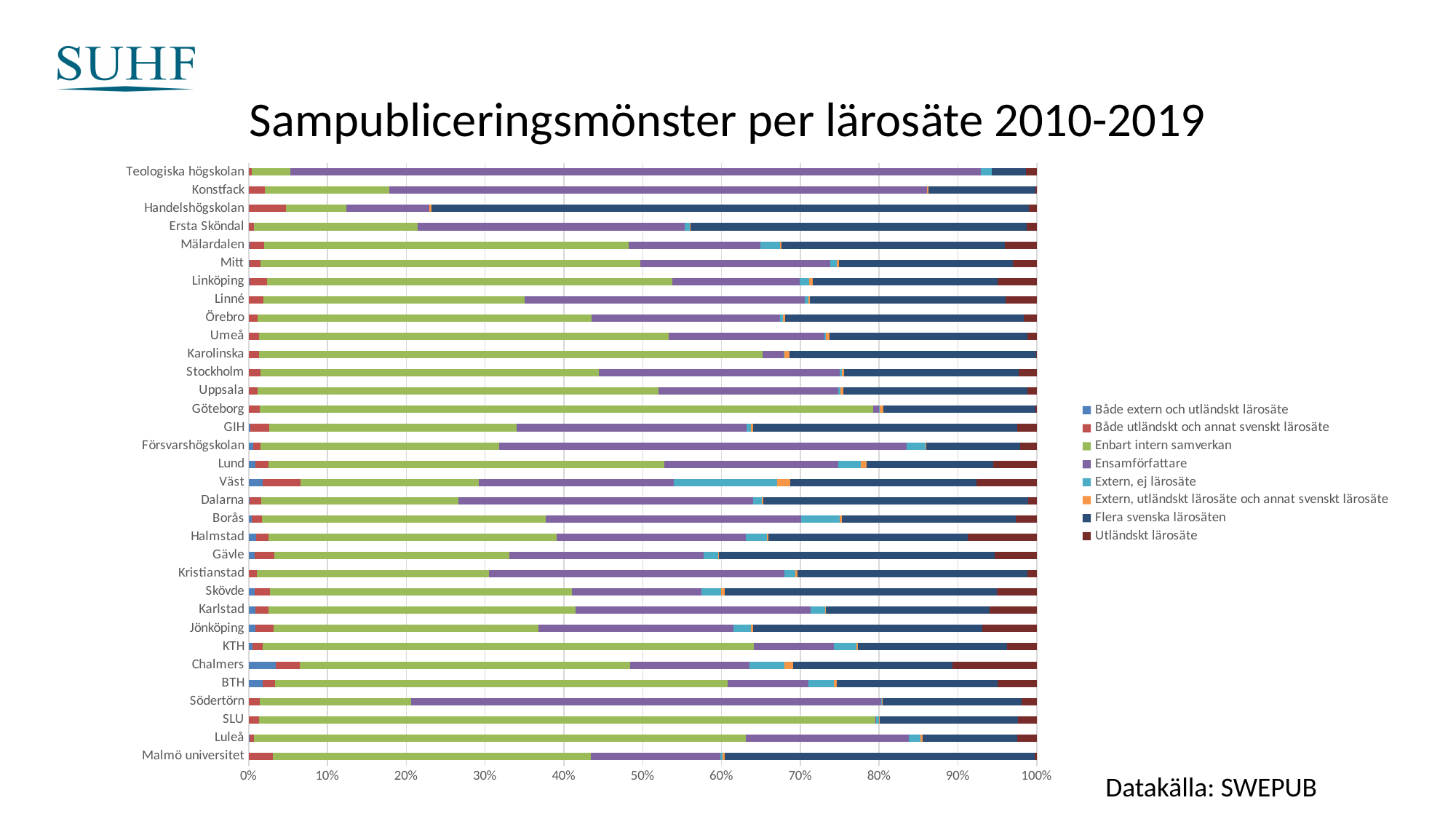
What does each stacked bar total on the x axis? 100% Which lärosäte has the largest share of Flera svenska lärosäten? Handelshögskolan Which has the larger Enbart intern samverkan share, Göteborg or Konstfack? Göteborg How many series does the legend list? 8 Which data source is cited for the chart? SWEPUB Is the Enbart intern samverkan share for Göteborg greater or less than 70%? greater How many lärosäten (categories) are plotted on the y axis? 33 Is the Enbart intern samverkan share for Handelshögskolan greater or less than 20%? less What is the title of the chart? Sampubliceringsmönster per lärosäte 2010-2019 Which lärosäte has the largest share of Ensamförfattare? Teologiska högskolan What kind of chart is shown on the slide? Stacked bar chart Is the Ensamförfattare share for Teologiska högskolan greater or less than 80%? greater